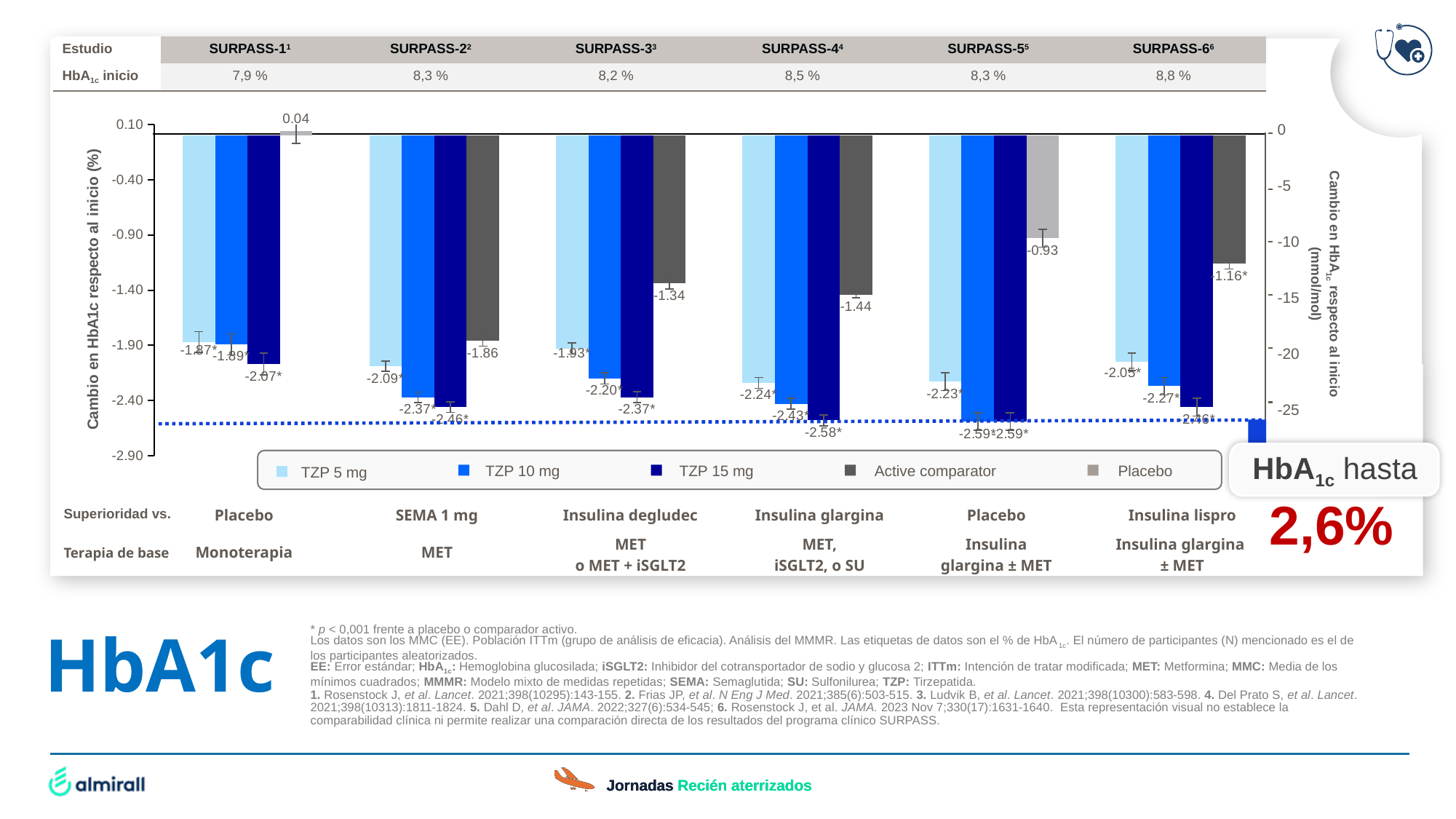
How many series does the chart legend list? 5 What type of chart is shown on the slide? Bar chart What is the change in HbA1c for TZP 15 mg in SURPASS-2? -2.46 What is the change in HbA1c for the placebo group in SURPASS-1? 0.04 What is the change in HbA1c for TZP 5 mg in SURPASS-4? -2.24 What baseline HbA1c is listed for SURPASS-6 in the table above the chart? 8,8 % What is the change in HbA1c for the placebo group in SURPASS-5? -0.93 Which study shows the largest HbA1c reduction for TZP 15 mg? SURPASS-5 In SURPASS-6, which shows a larger reduction in HbA1c: TZP 10 mg or the active comparator (insulin lispro)? TZP 10 mg What is the change in HbA1c for the active comparator in SURPASS-3? -1.34 What is the difference between the TZP 15 mg change (-2.58) and the active comparator change (-1.44) in SURPASS-4? 1.14 How many SURPASS studies are shown along the x axis of the chart? 6